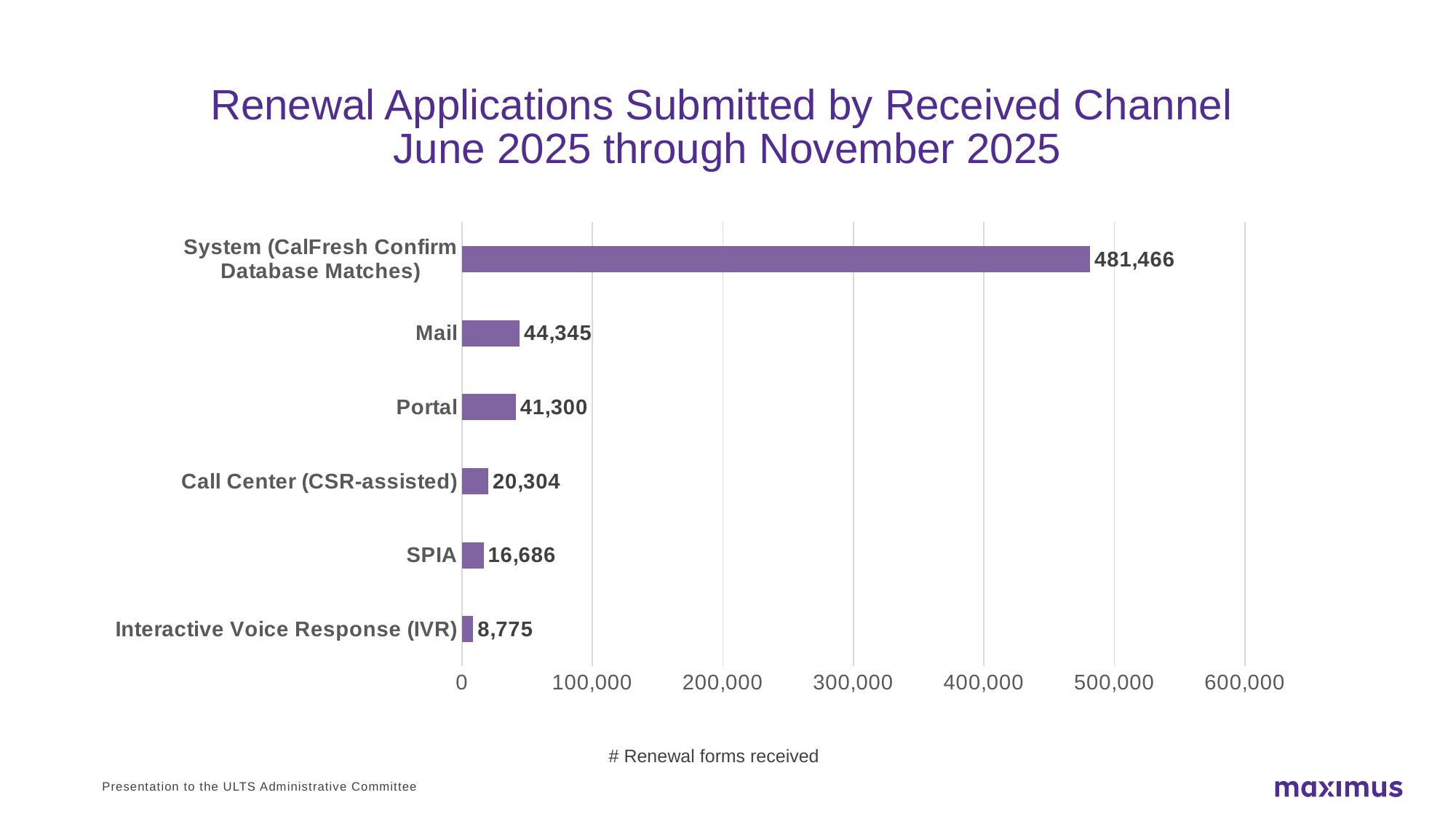
How many channels are shown in the chart? 6 Which channel has the lowest number of renewal applications? Interactive Voice Response (IVR) What is the value for the Portal channel? 41,300 Which is larger, Call Center (CSR-assisted) or SPIA? Call Center (CSR-assisted) Is the value for System (CalFresh Confirm Database Matches) greater or less than 400,000? greater What is the difference between the Mail and Portal values? 3,045 What is the difference between the SPIA and IVR values? 7,911 Which channel has the highest number of renewal applications? System (CalFresh Confirm Database Matches) What kind of chart is shown on the slide? Bar chart How many renewal forms were received via Interactive Voice Response (IVR)? 8,775 How many renewal applications were received through Mail? 44,345 What is the value for Call Center (CSR-assisted)? 20,304